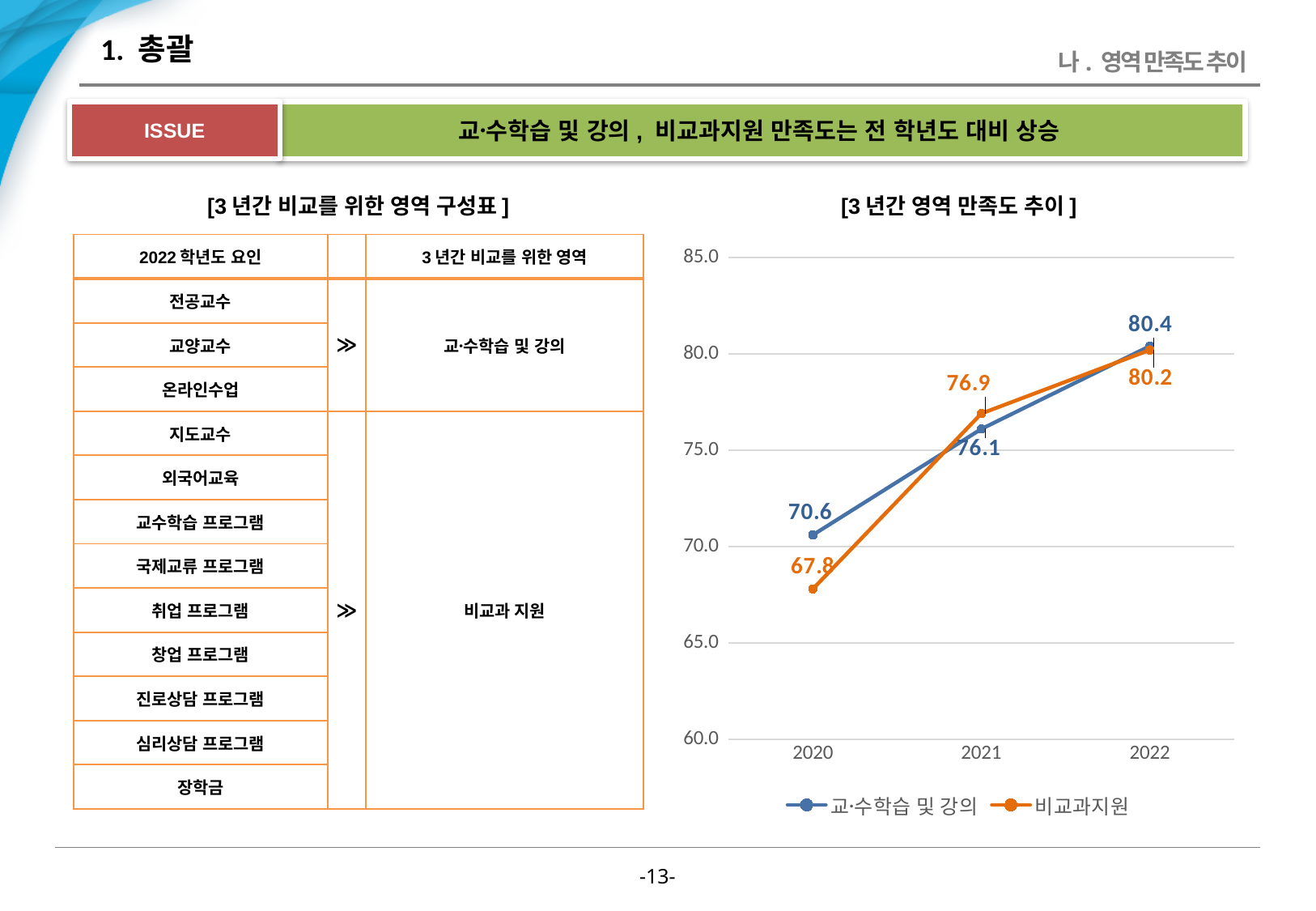
What is the difference between the 2022 and 2020 values for 교·수학습 및 강의? 9.8 What is the difference between the 2021 and 2020 values for 비교과지원? 9.1 How many series does the legend list? 2 In which year is the value for 교·수학습 및 강의 highest? 2022 What kind of chart is shown? line chart How many years are shown on the x axis? 3 What is the value for 교·수학습 및 강의 in 2020? 70.6 What is the value for 비교과지원 in 2022? 80.2 Is the value for 비교과지원 in 2020 greater or less than 70.0? less In which year is the value for 비교과지원 lowest? 2020 In 2020, which series has the larger value, 교·수학습 및 강의 or 비교과지원? 교·수학습 및 강의 What is the value for 비교과지원 in 2021? 76.9